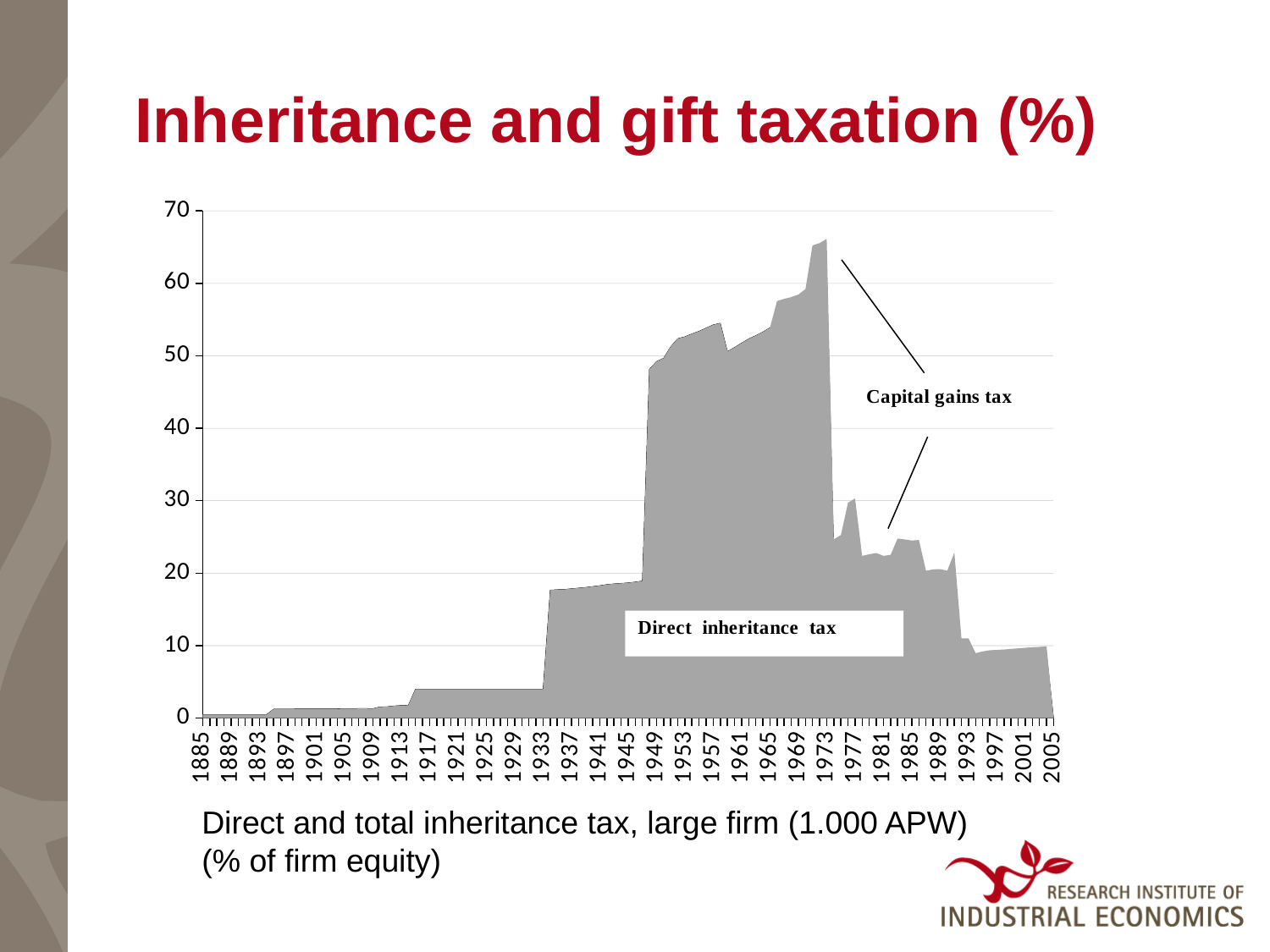
Is the value for 1977 greater or less than 40? less Is the value around 1973 greater or less than 60? greater What is the title of the chart on the slide? Inheritance and gift taxation (%) Is the value for 1965 greater or less than 50? greater Does the value rise or fall between 1949 and 1973? Rise What are the two labels written on the chart area identifying the tax components? Capital gains tax and Direct inheritance tax Does the value rise or fall between 1989 and 1993? Fall What kind of chart is shown on the slide? Area chart